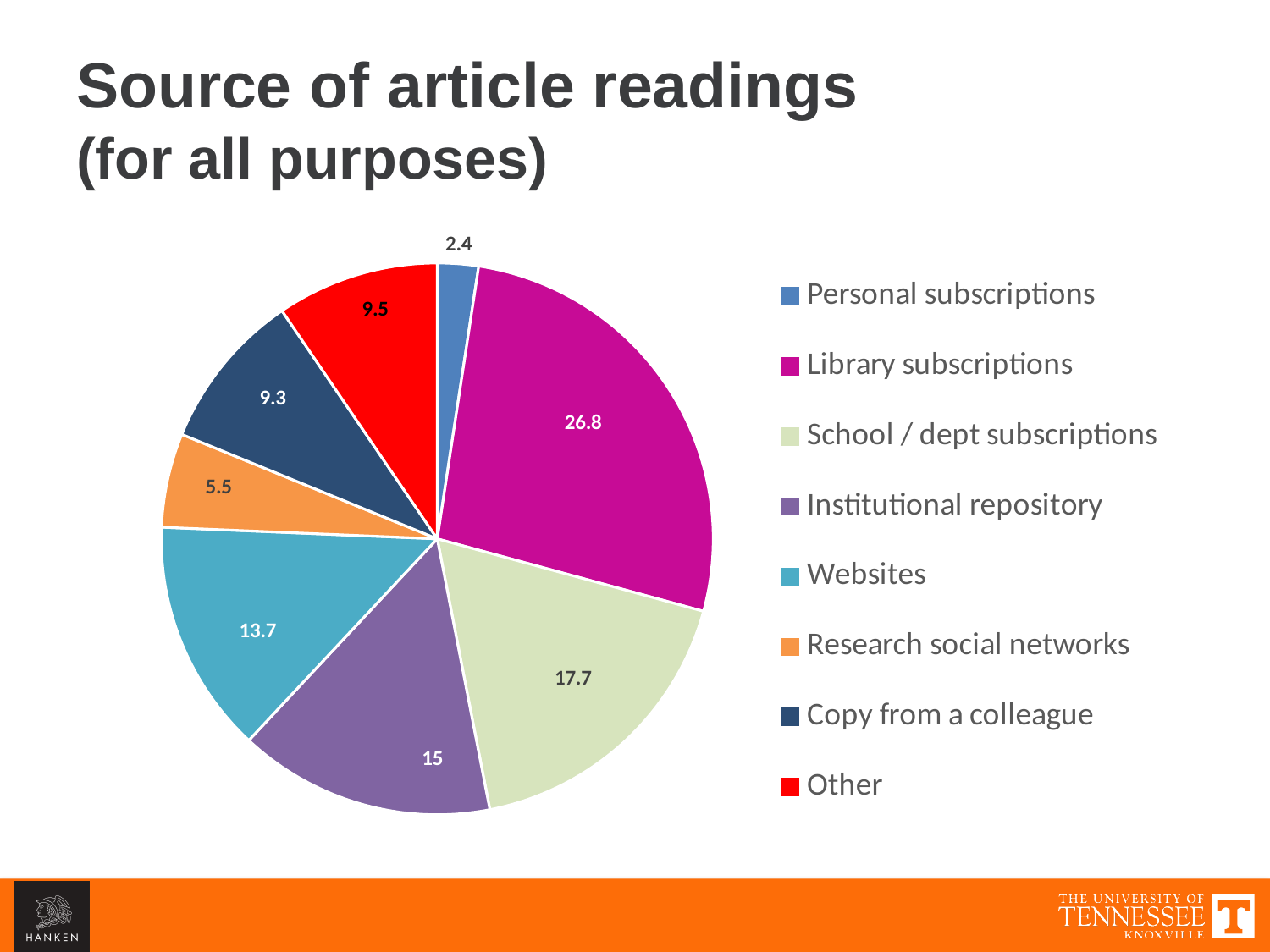
Which source has the largest slice of the pie? Library subscriptions What colour is the slice for Other? Red What is the value for Library subscriptions? 26.8 What kind of chart is shown on the slide? Pie chart What is the value for Personal subscriptions? 2.4 Which is larger, the value for Institutional repository or the value for Websites? Institutional repository What is the difference between the values for Websites and Research social networks? 8.2 What is the value for Websites? 13.7 What is the value for Institutional repository? 15 What is the difference between the values for Library subscriptions and School / dept subscriptions? 9.1 How many slices does the pie chart have? 8 Which source has the smallest slice of the pie? Personal subscriptions